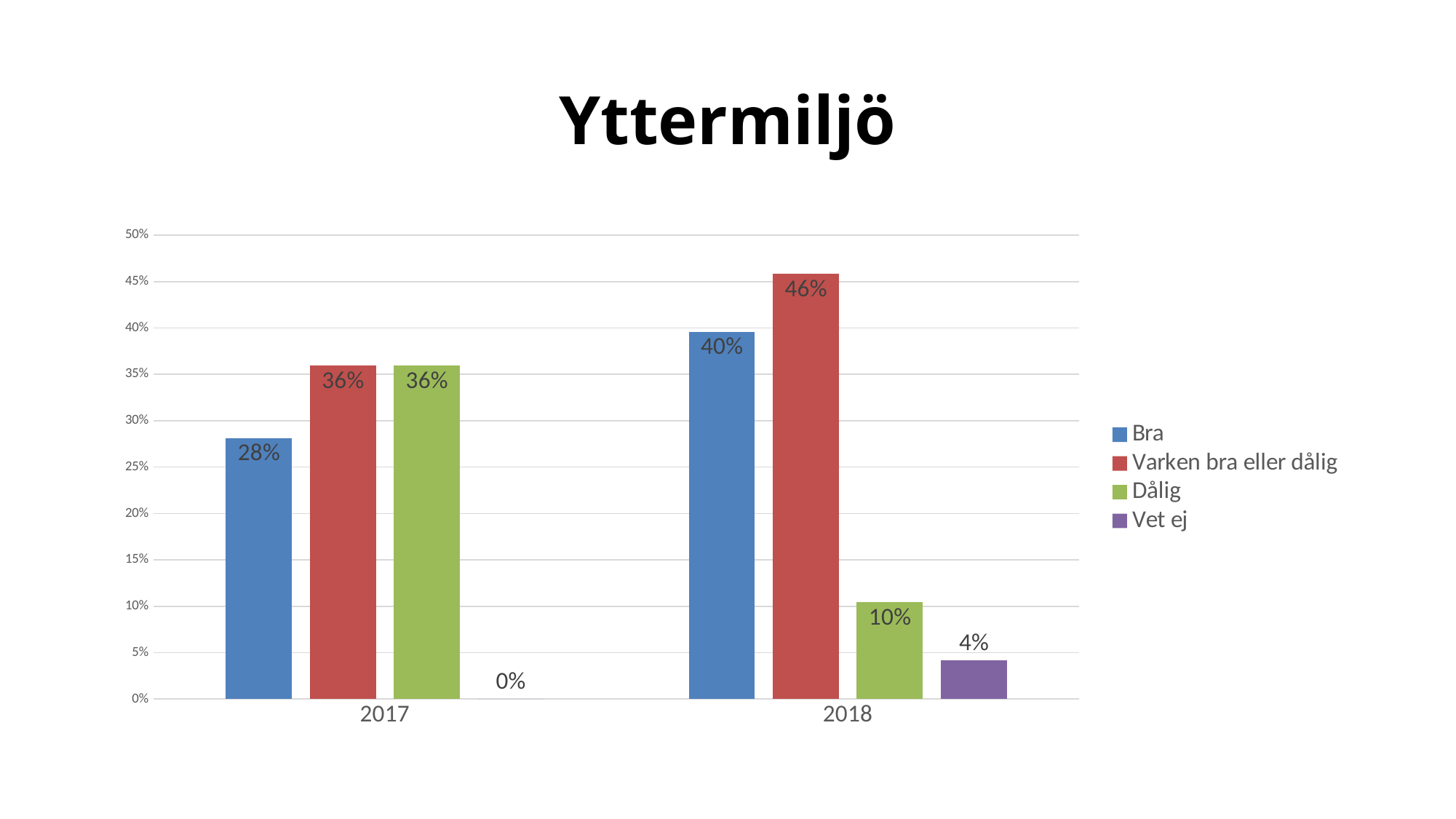
What kind of chart is shown on the slide? Bar chart What is the value for Varken bra eller dålig in 2018? 46% Which series has the highest value in 2018? Varken bra eller dålig How many categories are shown on the x axis? 2 What is the value for Bra in 2017? 28% Which series has the lowest value in 2018? Vet ej What is the title of the chart? Yttermiljö Which is larger: Dålig in 2017 or Dålig in 2018? Dålig in 2017 What is the value for Dålig in 2018? 10% How many series does the legend list? 4 What is the difference between the Bra values for 2018 and 2017? 12% What is the value for Vet ej in 2017? 0%